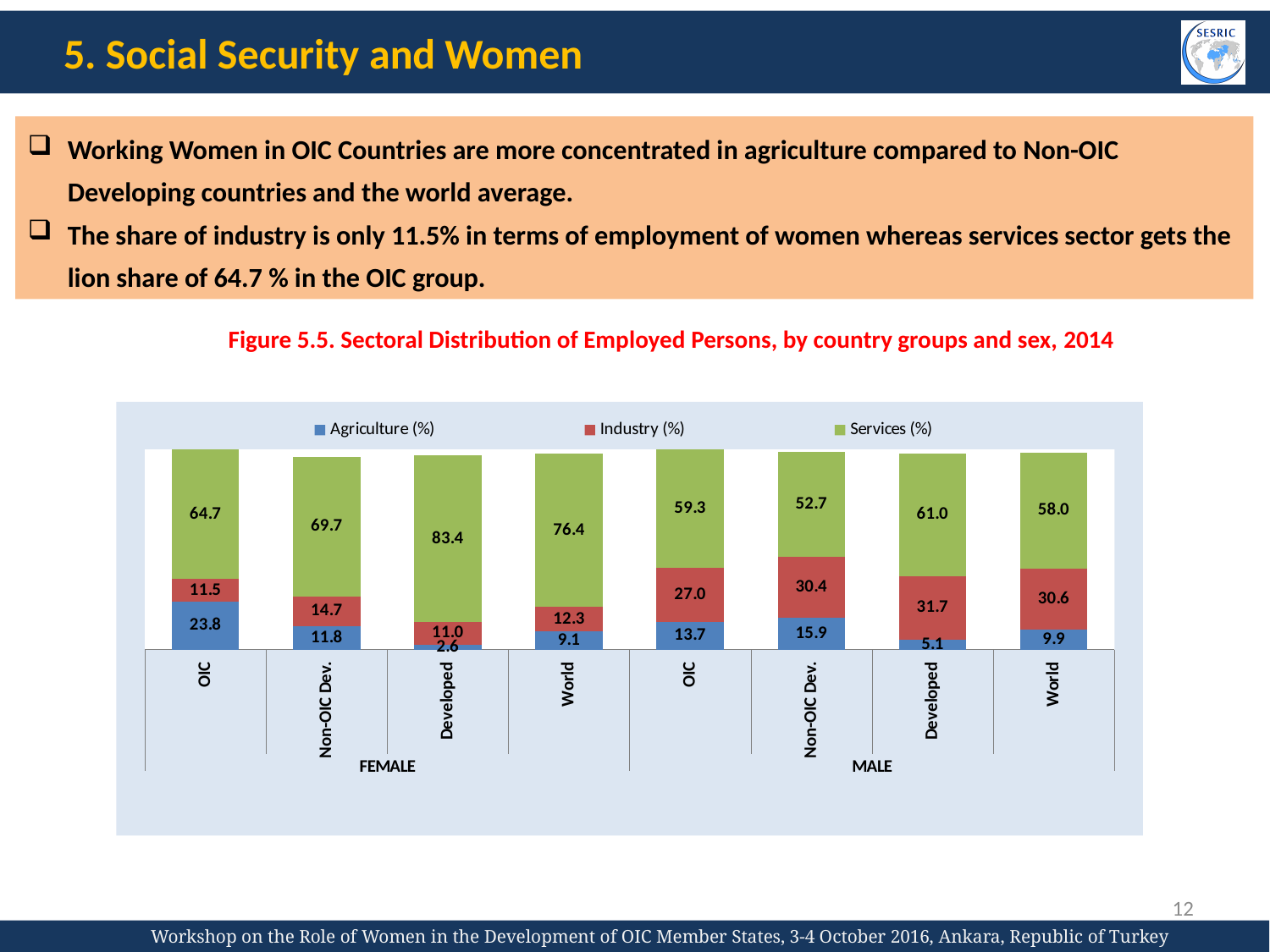
How many series does the legend list? 3 Which colour represents Agriculture (%) in the chart? Blue What is the Industry (%) value for Male Developed countries? 31.7 What is the Agriculture (%) value for Female OIC? 23.8 What is the total of the stacked bar for Female OIC? 100.0 Which is larger, the Industry (%) value for Female Non-OIC Dev. or Male Non-OIC Dev.? Male Non-OIC Dev. Which category has the highest Services (%) value? Female Developed What is the difference between the Services (%) value for Female OIC and Male OIC? 5.4 How many stacked bars are plotted in the chart? 8 What is the Services (%) value for Female Developed countries? 83.4 What kind of chart is shown in Figure 5.5? Stacked bar chart Which category has the lowest Agriculture (%) value? Female Developed